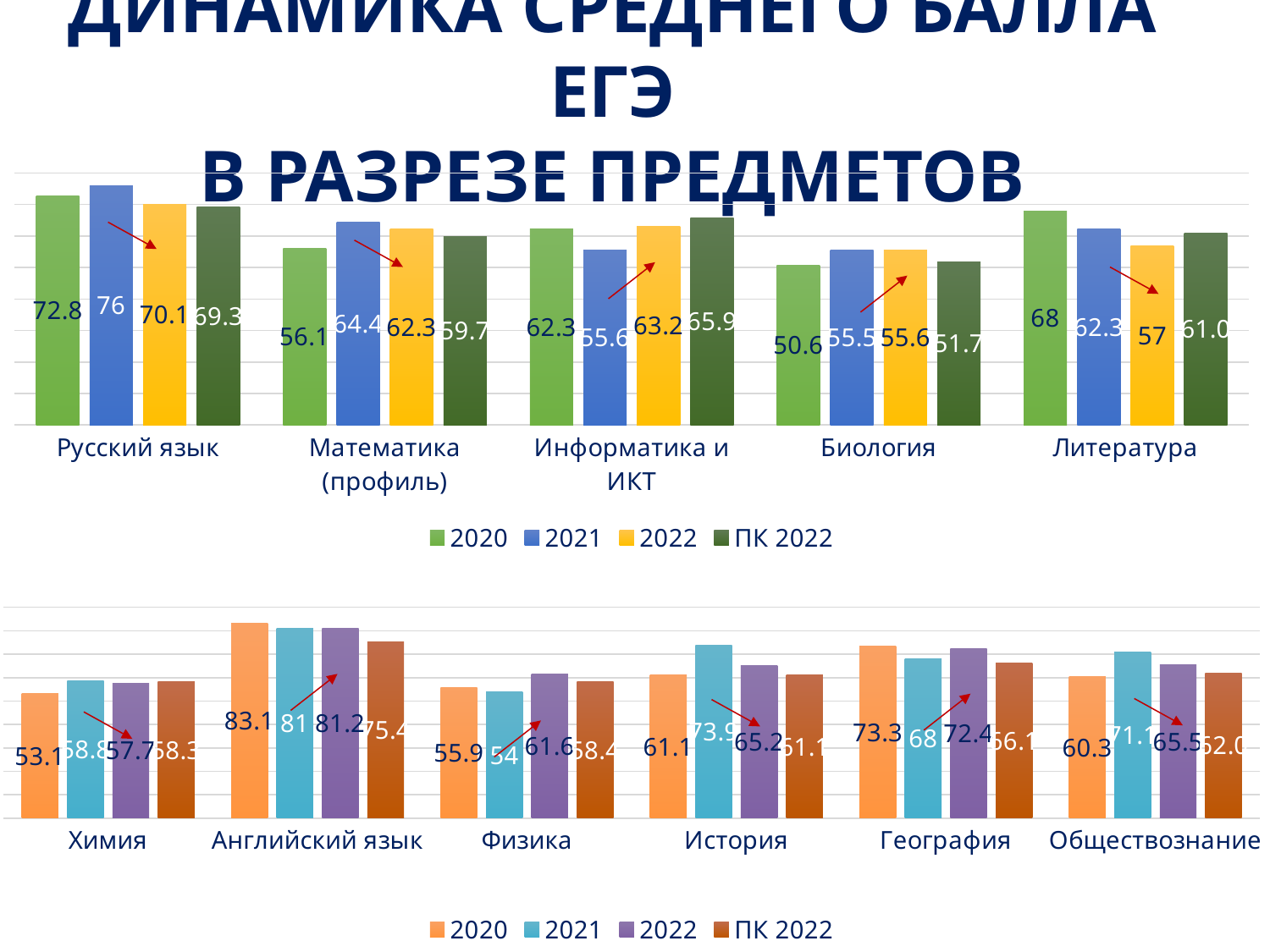
What type of chart is the bottom chart? Bar chart In the bottom chart, what is the 2020 value for Английский язык? 83.1 In the bottom chart, which is larger for Физика: the 2022 value or the 2021 value? 2022 In the top chart, what is the 2020 value for Биология? 50.6 In the top chart, how many series does the legend list? 4 In the top chart, which category has the highest 2020 value? Русский язык In the top chart, what is the 2021 value for Русский язык? 76 In the bottom chart, how many categories are shown on the x axis? 6 In the top chart, what is the difference between the 2021 and 2020 values for Математика (профиль)? 8.3 In the top chart, what is the 2022 value for Литература? 57 In the bottom chart, which category has the lowest 2020 value? Химия In the bottom chart, what is the 2021 value for История? 73.9